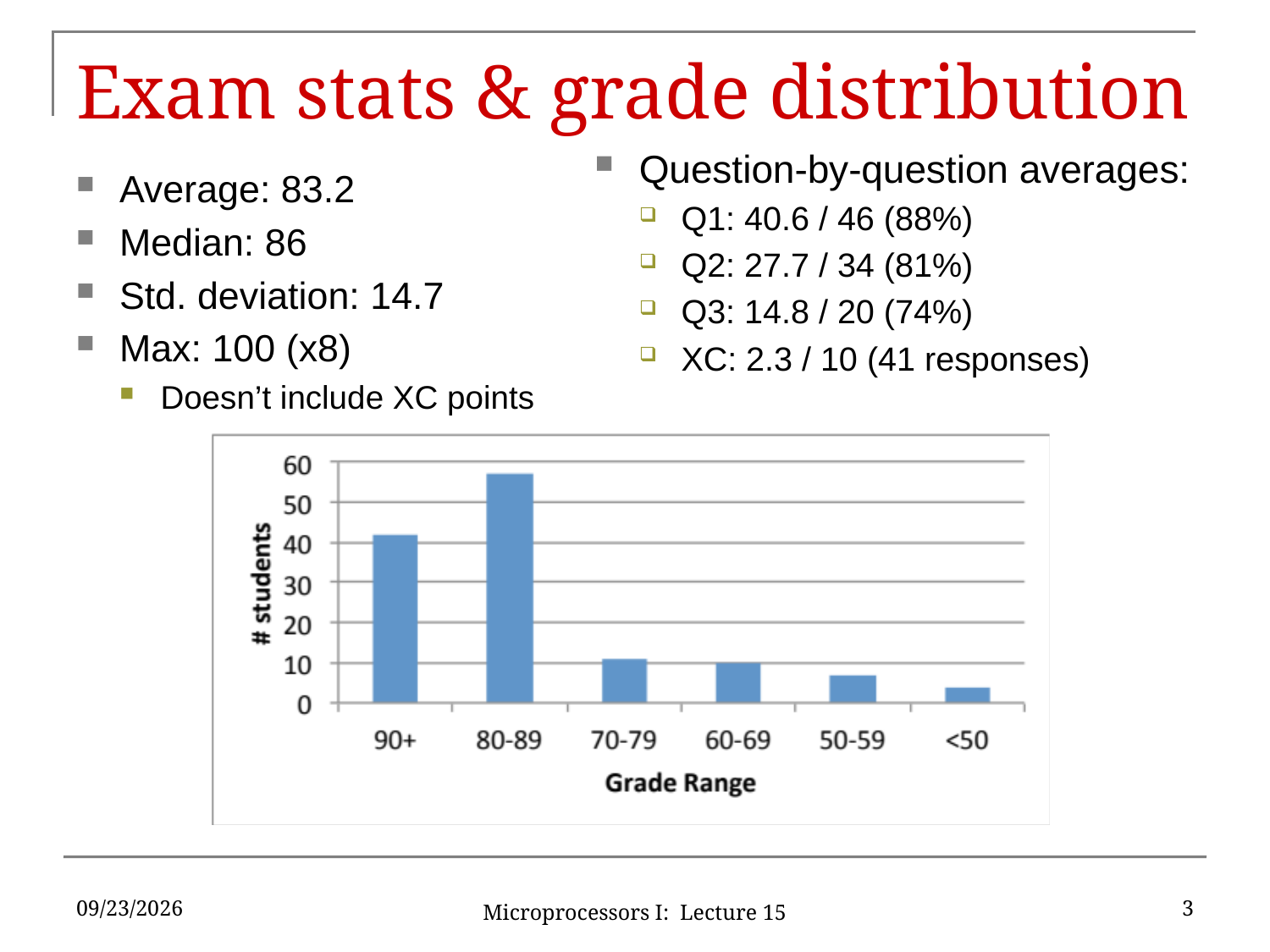
What is the label of the y axis of the chart? # students Is the number of students in the 80-89 range greater or less than 50? greater Is the number of students in the 90+ range greater or less than 40? greater Which grade range has the lowest number of students? <50 Is the number of students in the <50 range greater or less than 10? less What kind of chart is shown on the slide? bar chart Which grade range has the highest number of students? 80-89 Which grade range has more students, 90+ or 80-89? 80-89 How many grade ranges are shown on the x axis of the chart? 6 What is the label of the x axis of the chart? Grade Range Which grade range has more students, 50-59 or <50? 50-59